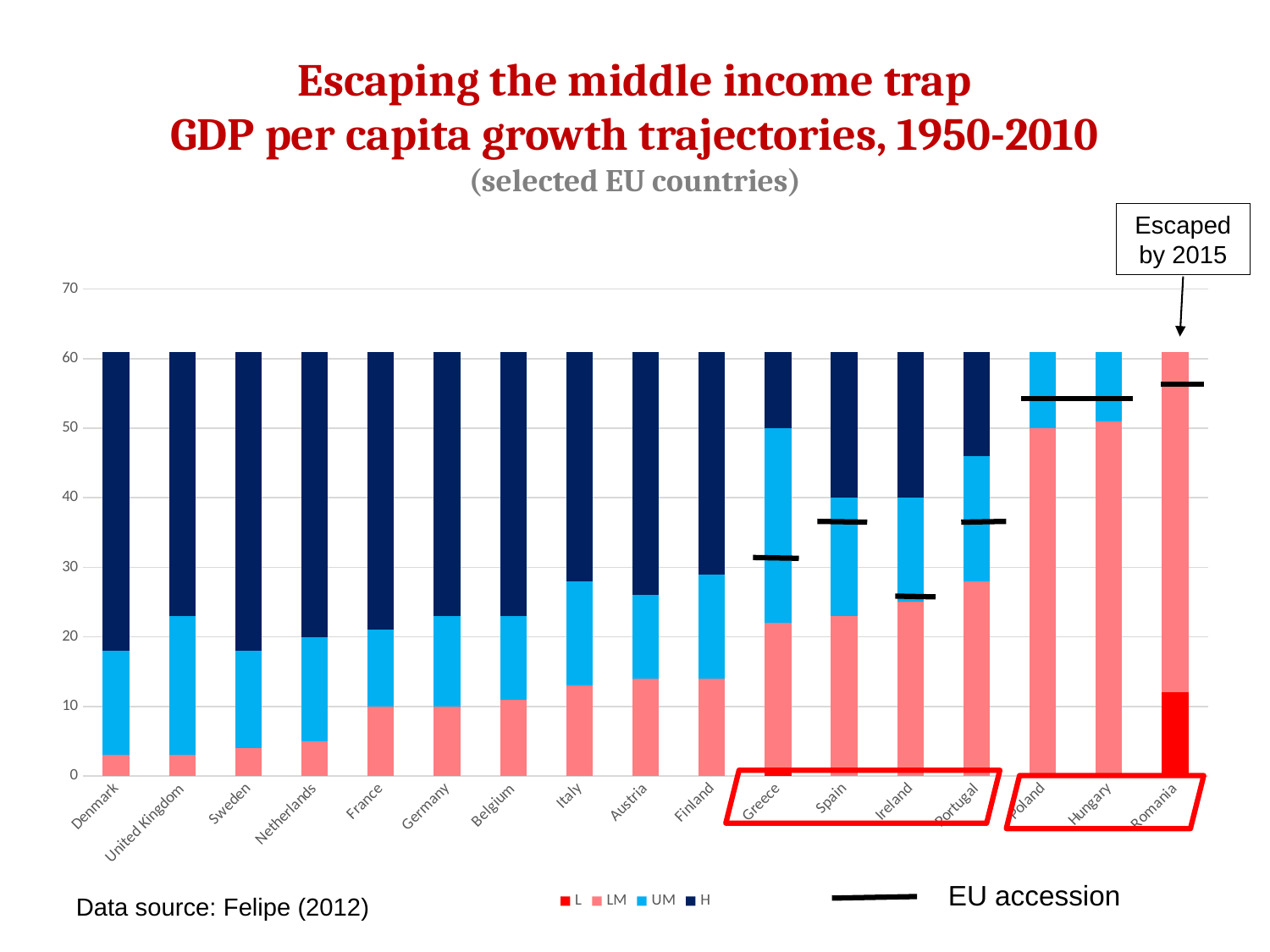
How many series does the chart legend list? 4 Is the top of the UM segment for Greece greater or less than 40? greater Is the top of the L segment for Romania greater or less than 20? less Is the top of the LM segment for Poland greater or less than 40? greater What kind of chart is shown on the slide? Stacked bar chart Which country has the largest UM segment? Greece How many countries are shown on the x axis of the chart? 17 Which country is marked with the annotation 'Escaped by 2015'? Romania What are the four series names listed in the chart legend? L, LM, UM, H Which country has a larger LM segment, Poland or Denmark? Poland